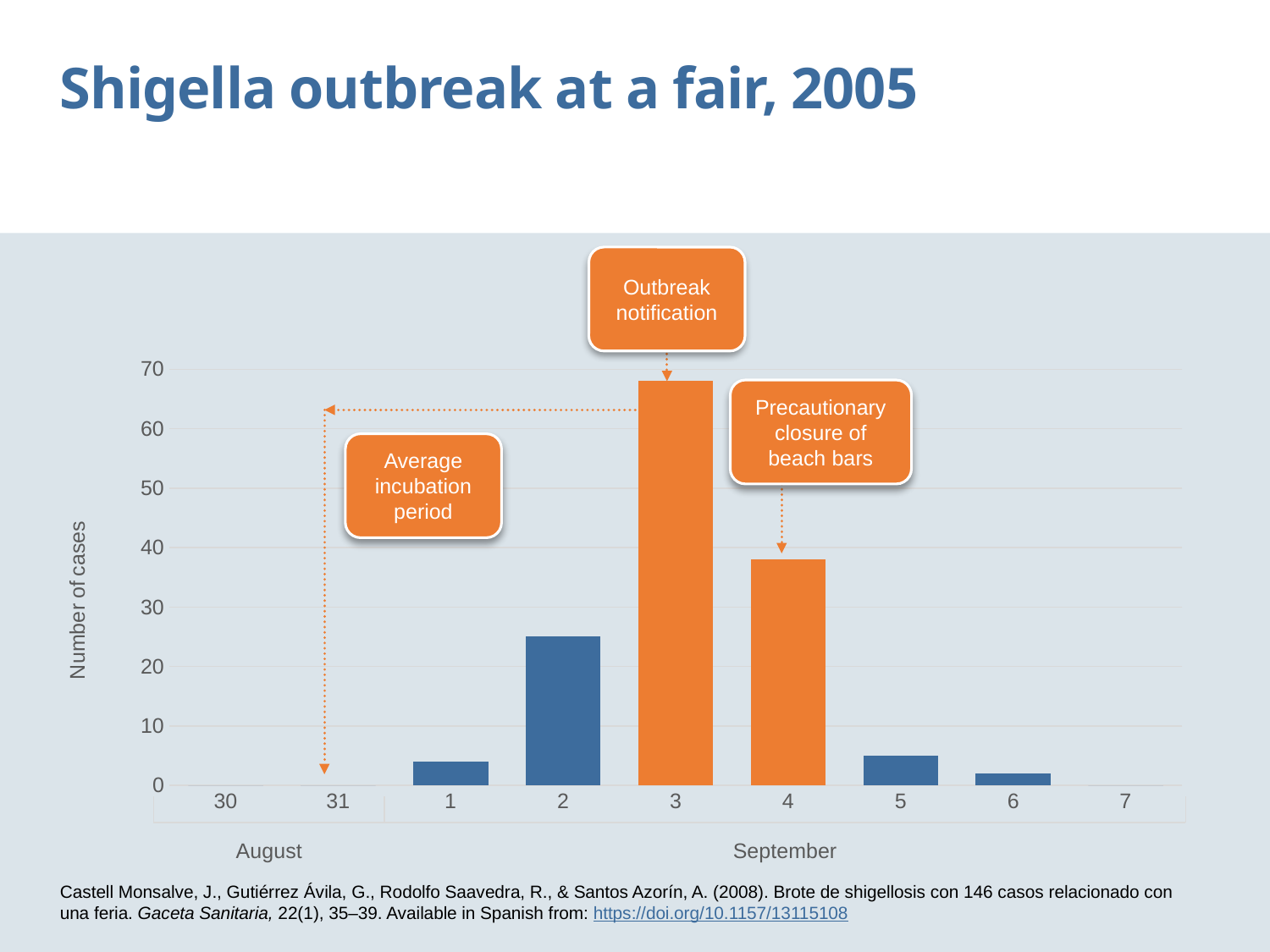
Which date has more cases, 1 September or 5 September? 5 September Is the number of cases on 4 September greater or less than 30? greater What is the label on the y axis? Number of cases On which date is the number of cases highest? 3 September How many dates are labelled on the x axis? 9 Is the number of cases on 2 September greater or less than 20? greater Do the number of cases rise or fall from 3 September to 6 September? Fall What kind of chart is shown on the slide? Bar chart Is the number of cases on 3 September greater or less than 60? greater Which date has more cases, 2 September or 4 September? 4 September